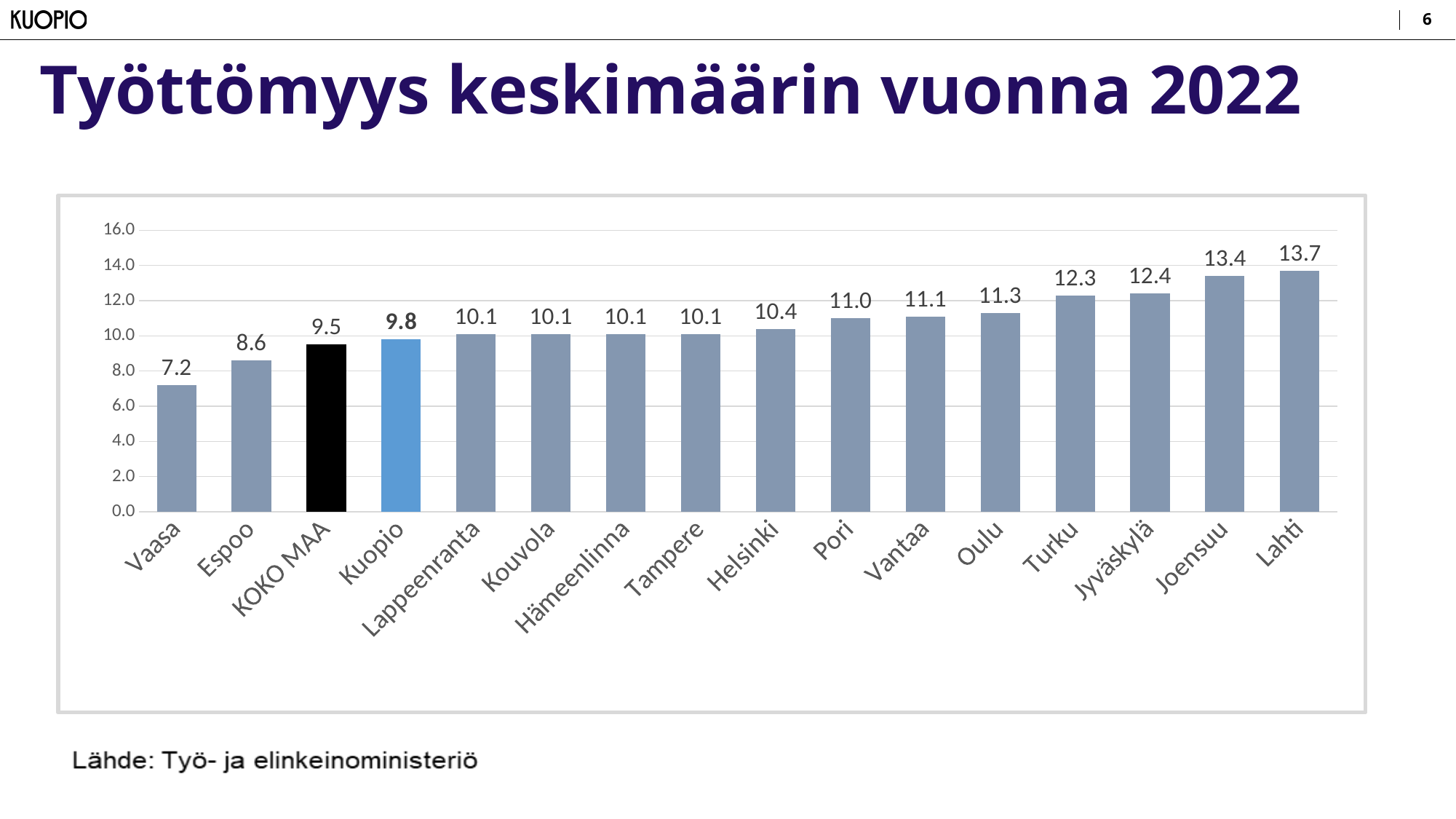
How many categories are shown on the x axis? 16 What is the difference between the values for Kuopio and KOKO MAA? 0.3 What is the value for Kuopio? 9.8 What is the value for Turku? 12.3 Which bar is coloured blue? Kuopio Which is larger, the value for Espoo or the value for Helsinki? Helsinki What kind of chart is shown on the slide? Bar chart Which category has the highest value? Lahti Which category has the lowest value? Vaasa Do the values rise or fall from left to right along the x axis? Rise What is the value for KOKO MAA? 9.5 What is the difference between the values for Lahti and Vaasa? 6.5